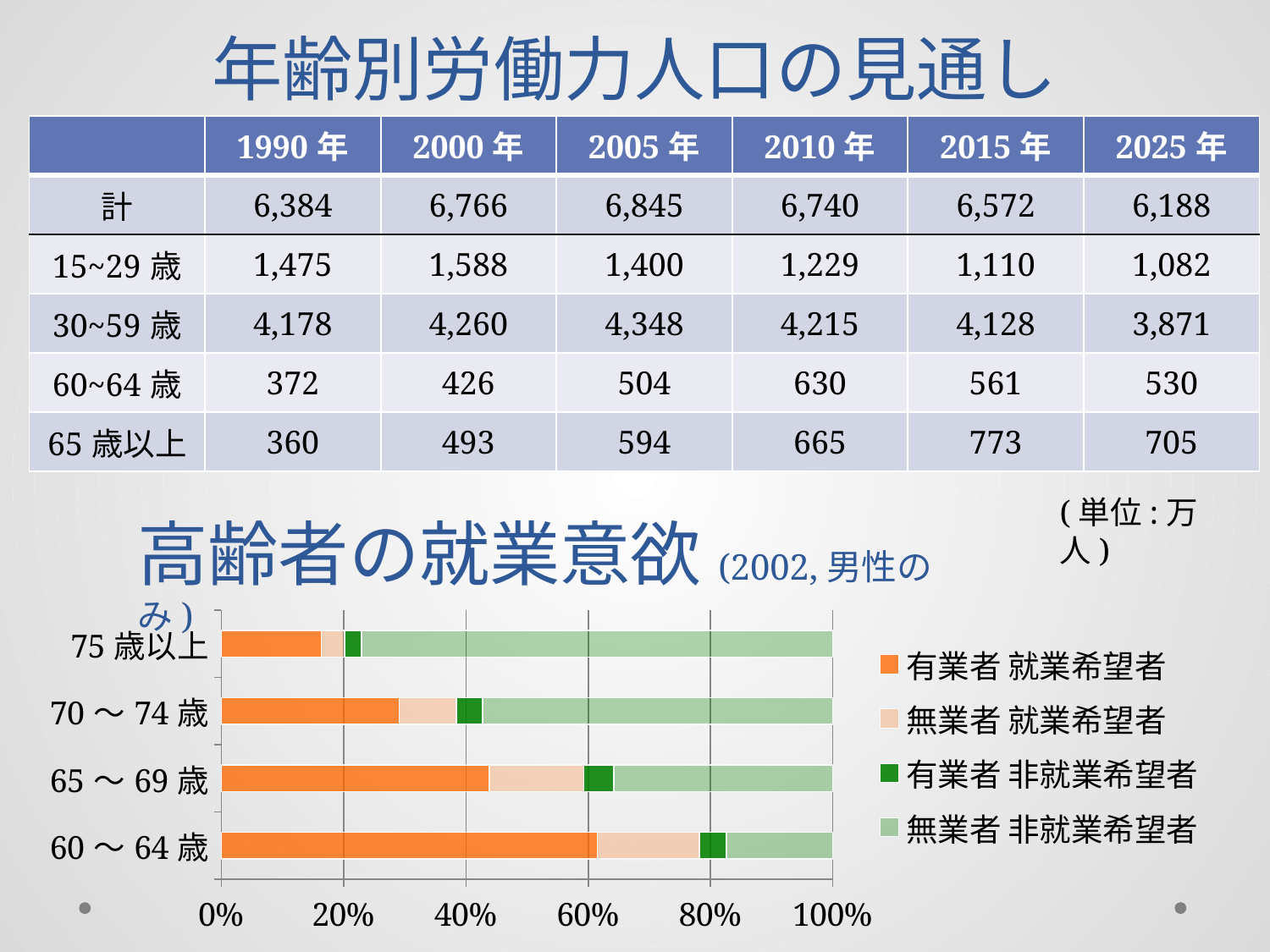
In the 高齢者の就業意欲 chart, which age group has the smallest share of 有業者 就業希望者? 75歳以上 What is the first entry in the legend of the 高齢者の就業意欲 chart? 有業者 就業希望者 In the 高齢者の就業意欲 chart, which age group has the largest share of 有業者 就業希望者? 60～64歳 How many age groups are plotted in the 高齢者の就業意欲 chart? 4 How many series does the legend of the 高齢者の就業意欲 chart list? 4 In the 高齢者の就業意欲 chart, is the 有業者 就業希望者 share for 70～74歳 greater or less than 40%? less In the 高齢者の就業意欲 chart, is the 有業者 就業希望者 share for 75歳以上 greater or less than 20%? less In the 高齢者の就業意欲 chart, which has the larger 有業者 就業希望者 share, 60～64歳 or 65～69歳? 60～64歳 In the 高齢者の就業意欲 chart, which age group has the largest share of 無業者 非就業希望者? 75歳以上 In the 高齢者の就業意欲 chart, is the 有業者 就業希望者 share for 65～69歳 greater or less than 40%? greater What kind of chart is shown under the heading 高齢者の就業意欲? Stacked bar chart In the 高齢者の就業意欲 chart, does the share of 有業者 就業希望者 rise or fall as the age group gets older? fall